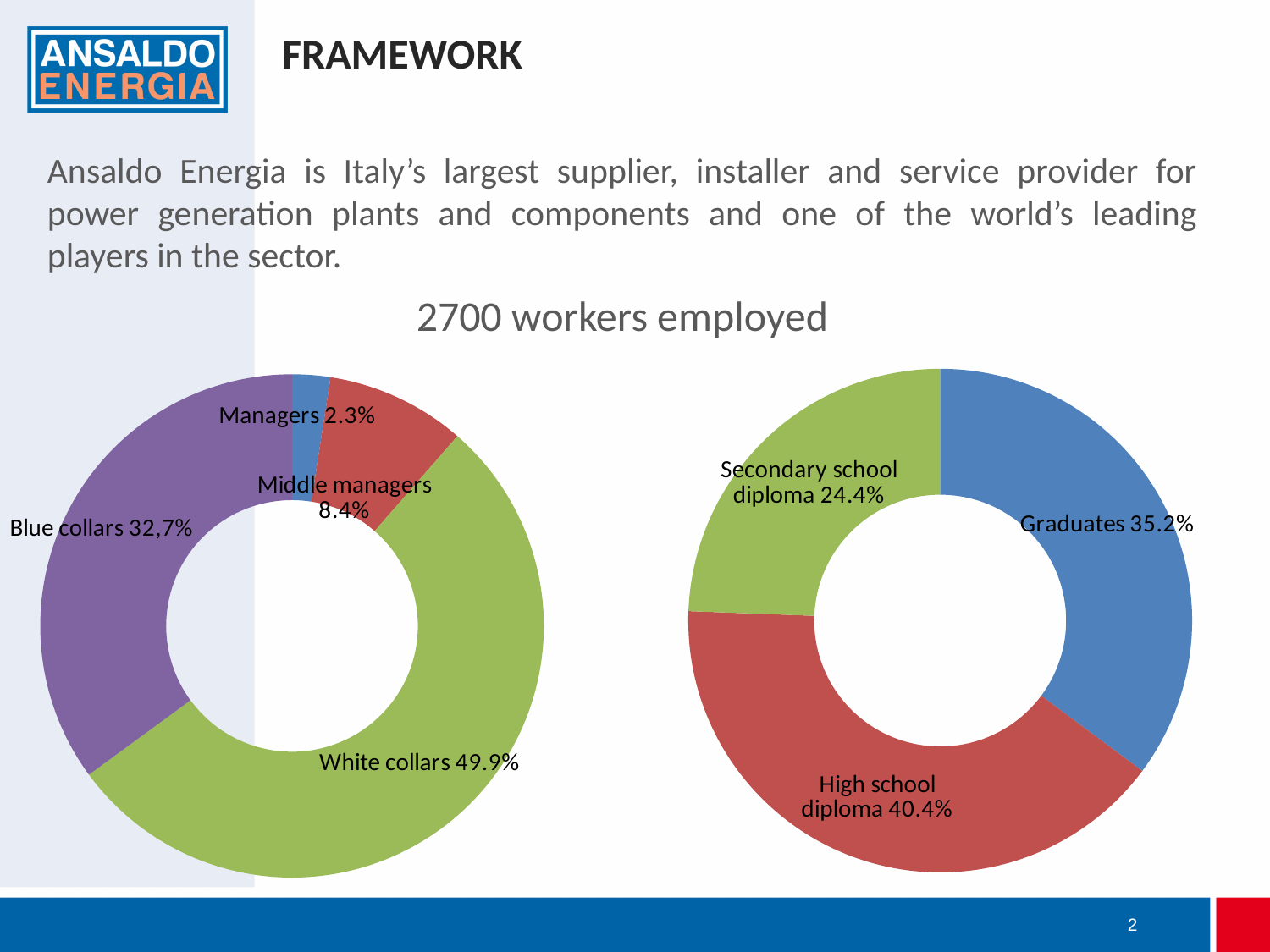
On the right chart, which category has the smallest share? Secondary school diploma On the left chart, how many categories are shown? 4 On the left chart, what share of workers are Managers? 2.3% On the left chart, which category has the smallest share? Managers On the right chart, what share of workers are Graduates? 35.2% What type of chart is used on the right side of the slide? Doughnut chart On the left chart, what is the difference between the Middle managers share and the Managers share? 6.1% On the left chart, what share of workers are White collars? 49.9% On the left chart, what share of workers are Blue collars? 32,7% On the right chart, what share of workers have a High school diploma? 40.4% On the right chart, which is larger: Graduates or High school diploma? High school diploma On the left chart, which category has the largest share? White collars